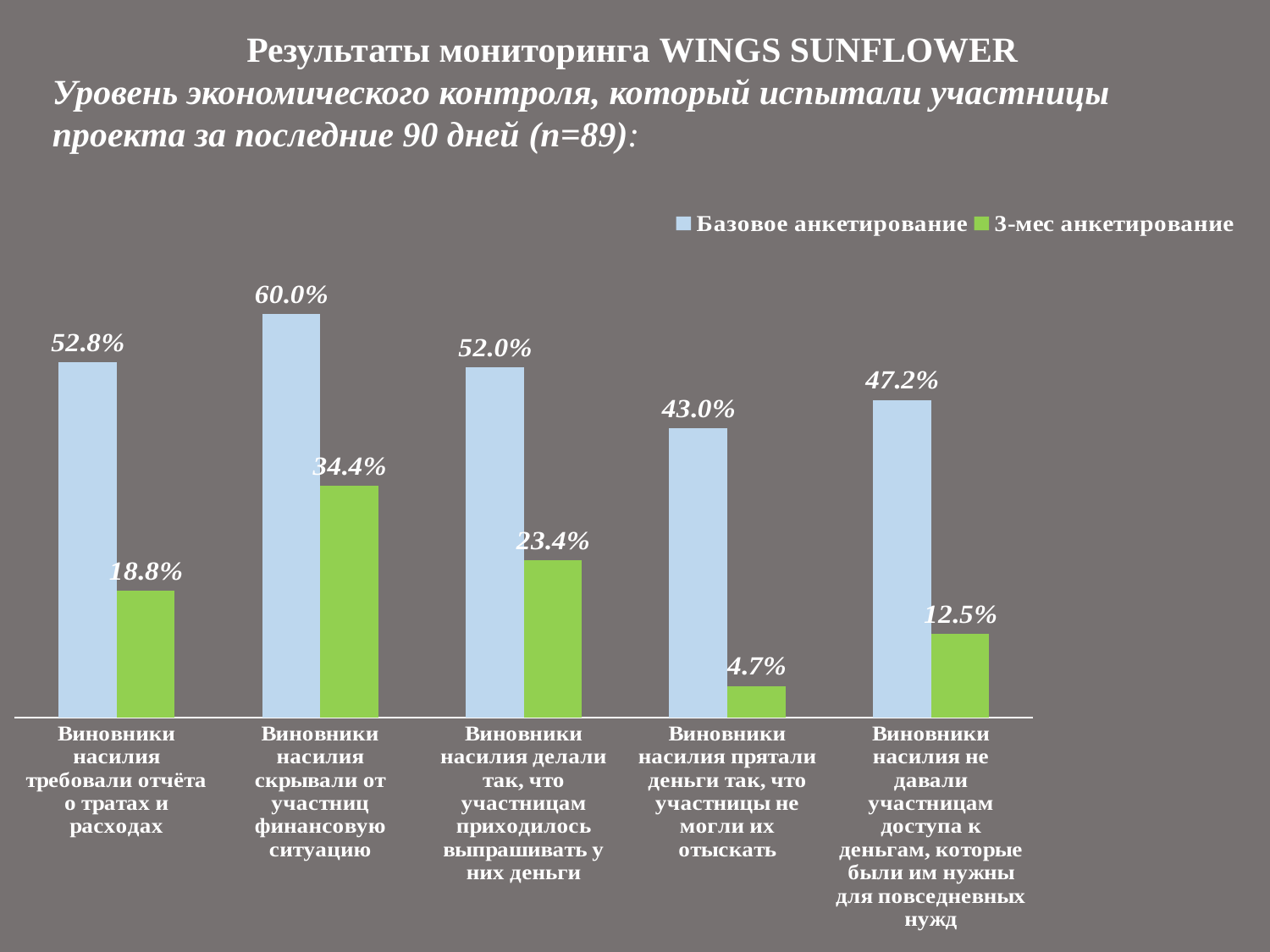
What is the value for "3-мес анкетирование" in the category "Виновники насилия прятали деньги так, что участницы не могли их отыскать"? 4.7% Which series is shown in green? 3-мес анкетирование What is the value for "Базовое анкетирование" in the category "Виновники насилия скрывали от участниц финансовую ситуацию"? 60.0% What is the difference between the "Базовое анкетирование" and "3-мес анкетирование" values for "Виновники насилия не давали участницам доступа к деньгам, которые были им нужны для повседневных нужд"? 34.7% What kind of chart is shown on the slide? Bar chart What is the difference between the "Базовое анкетирование" and "3-мес анкетирование" values for "Виновники насилия делали так, что участницам приходилось выпрашивать у них деньги"? 28.6% How many categories are shown on the x axis? 5 What is the value for "3-мес анкетирование" in the category "Виновники насилия требовали отчёта о тратах и расходах"? 18.8% Which category has the lowest value for "3-мес анкетирование"? Виновники насилия прятали деньги так, что участницы не могли их отыскать How many series does the legend list? 2 Which category has the highest value for "Базовое анкетирование"? Виновники насилия скрывали от участниц финансовую ситуацию Which is larger: the "Базовое анкетирование" value for "Виновники насилия прятали деньги так, что участницы не могли их отыскать" or for "Виновники насилия не давали участницам доступа к деньгам, которые были им нужны для повседневных нужд"? Виновники насилия не давали участницам доступа к деньгам, которые были им нужны для повседневных нужд